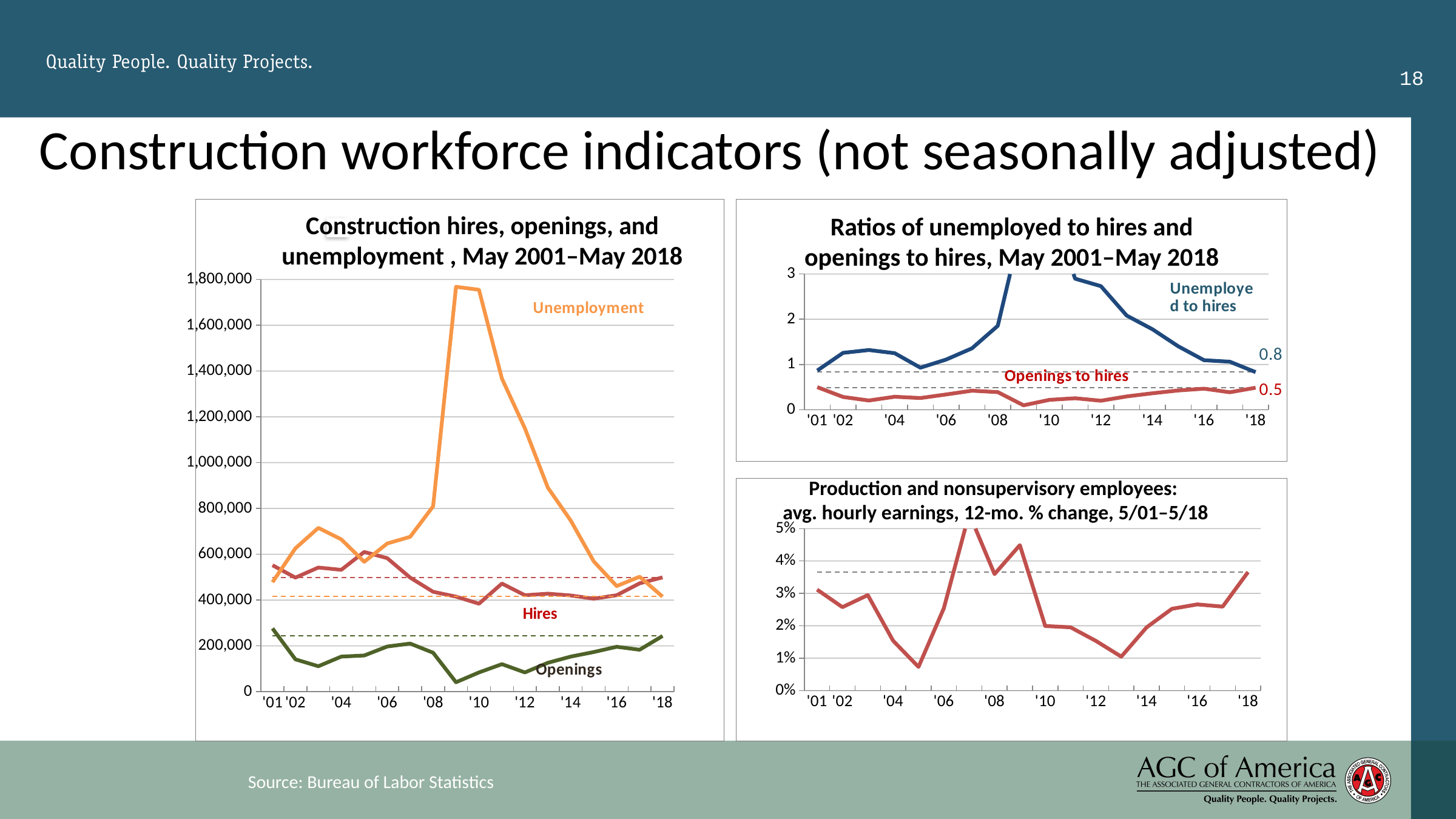
In the chart titled "Construction hires, openings, and unemployment, May 2001–May 2018", is the Openings value in '09 greater or less than 200,000? less In the chart titled "Ratios of unemployed to hires and openings to hires, May 2001–May 2018", what is the difference between the labelled '18 values for unemployed to hires and openings to hires? 0.3 In the chart titled "Production and nonsupervisory employees: avg. hourly earnings, 12-mo. % change, 5/01–5/18", does the line rise or fall from '09 to '13? Fall In the chart titled "Production and nonsupervisory employees: avg. hourly earnings, 12-mo. % change, 5/01–5/18", is the value in '05 greater or less than 1%? less In the chart titled "Construction hires, openings, and unemployment, May 2001–May 2018", is the Unemployment value in '09 greater or less than 1,600,000? greater In the chart titled "Ratios of unemployed to hires and openings to hires, May 2001–May 2018", what is the ratio of openings to hires at the end of the series ('18)? 0.5 What kind of chart is the one titled "Construction hires, openings, and unemployment, May 2001–May 2018"? Line chart In the chart titled "Construction hires, openings, and unemployment, May 2001–May 2018", how many series are plotted? 6 In the chart titled "Ratios of unemployed to hires and openings to hires, May 2001–May 2018", what is the ratio of unemployed to hires at the end of the series ('18)? 0.8 In the chart titled "Ratios of unemployed to hires and openings to hires, May 2001–May 2018", which series has the higher labelled value in '18: unemployed to hires or openings to hires? Unemployed to hires